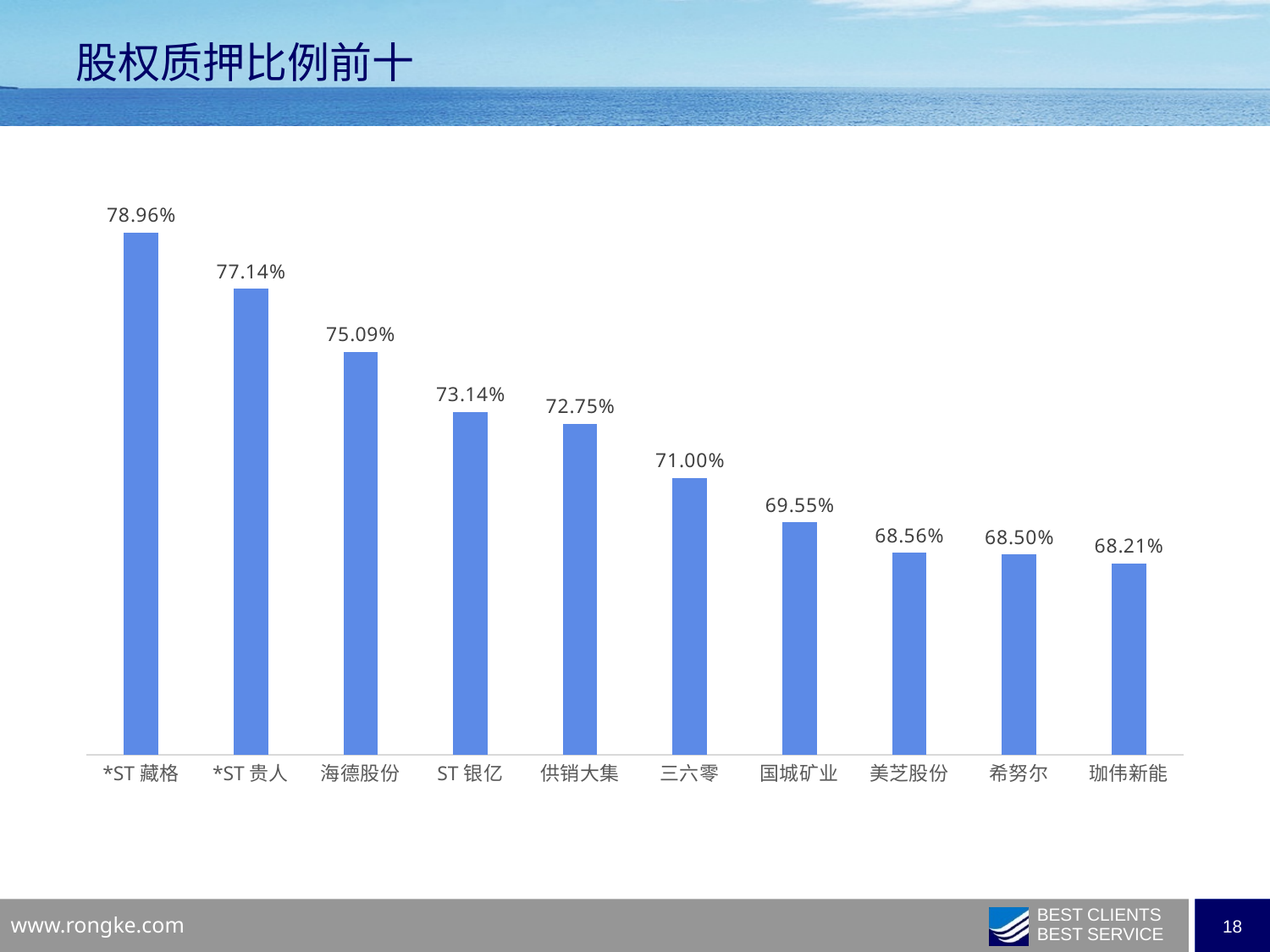
What is the difference between the values for ST 银亿 and 国城矿业? 3.59% Which category has the highest value? *ST 藏格 Which is larger, the value for 供销大集 or the value for 美芝股份? 供销大集 Which category has the lowest value? 珈伟新能 What is the value for *ST 藏格? 78.96% What is the difference between the values for *ST 藏格 and *ST 贵人? 1.82% How many categories are shown in the chart? 10 What kind of chart is shown on the slide? bar chart What is the value for 珈伟新能? 68.21% What is the value for 海德股份? 75.09% What is the value for 三六零? 71.00% Do the values rise or fall from left to right along the x axis? fall